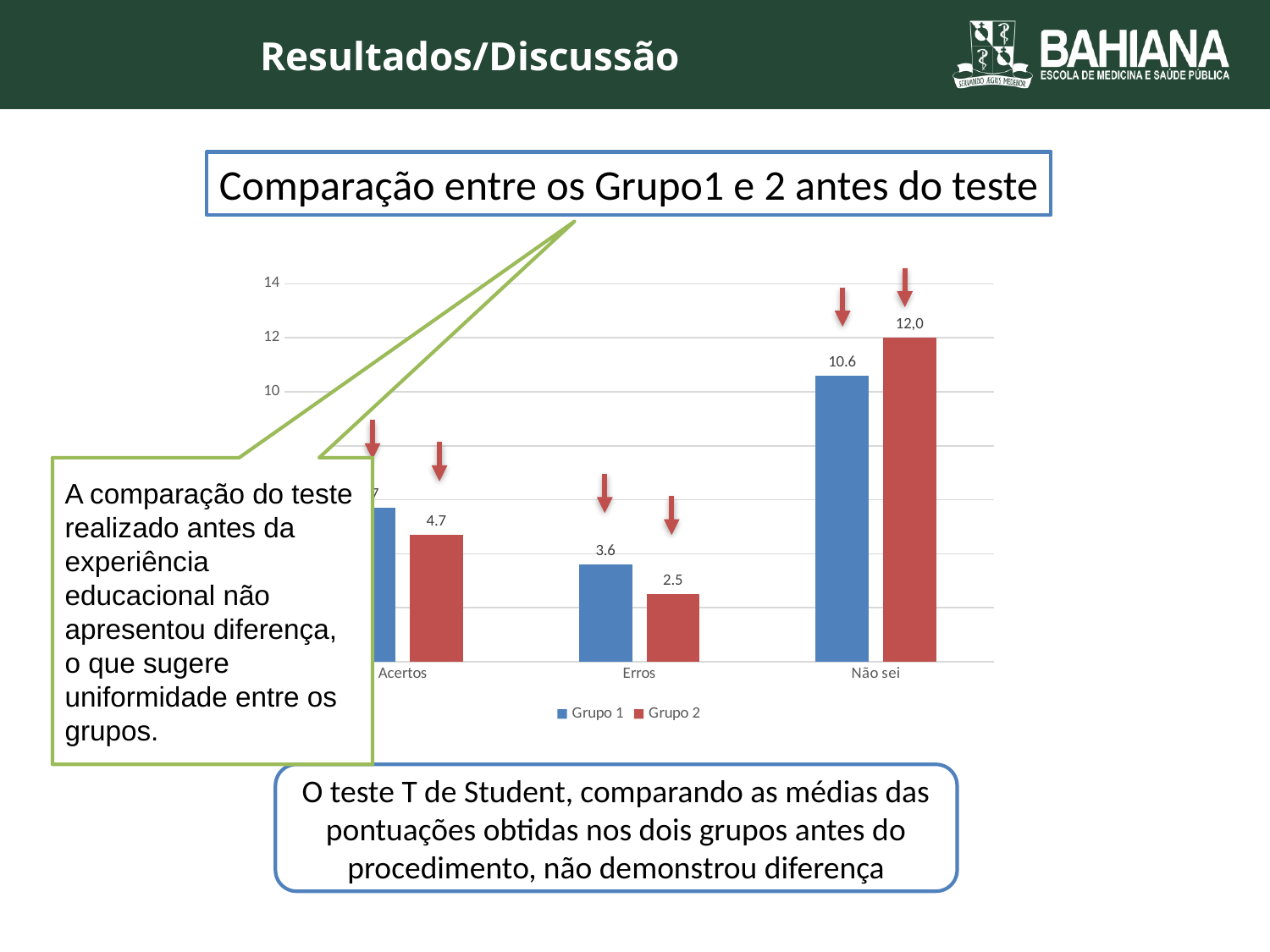
In which category does Grupo 2 have its highest value? Não sei What is the value for Grupo 2 in the Erros category? 2.5 What is the value for Grupo 1 in the Não sei category? 10.6 What is the value for Grupo 2 in the Não sei category? 12,0 How many categories are shown on the x axis of the chart? 3 What is the value for Grupo 2 in the Acertos category? 4.7 What is the value for Grupo 1 in the Erros category? 3.6 In which category does Grupo 1 have its lowest value? Erros Is the value for Grupo 1 in the Acertos category greater or less than 10? less How many series does the legend list? 2 What is the difference between Grupo 1 and Grupo 2 in the Erros category? 1.1 In the Não sei category, which group has the larger value? Grupo 2